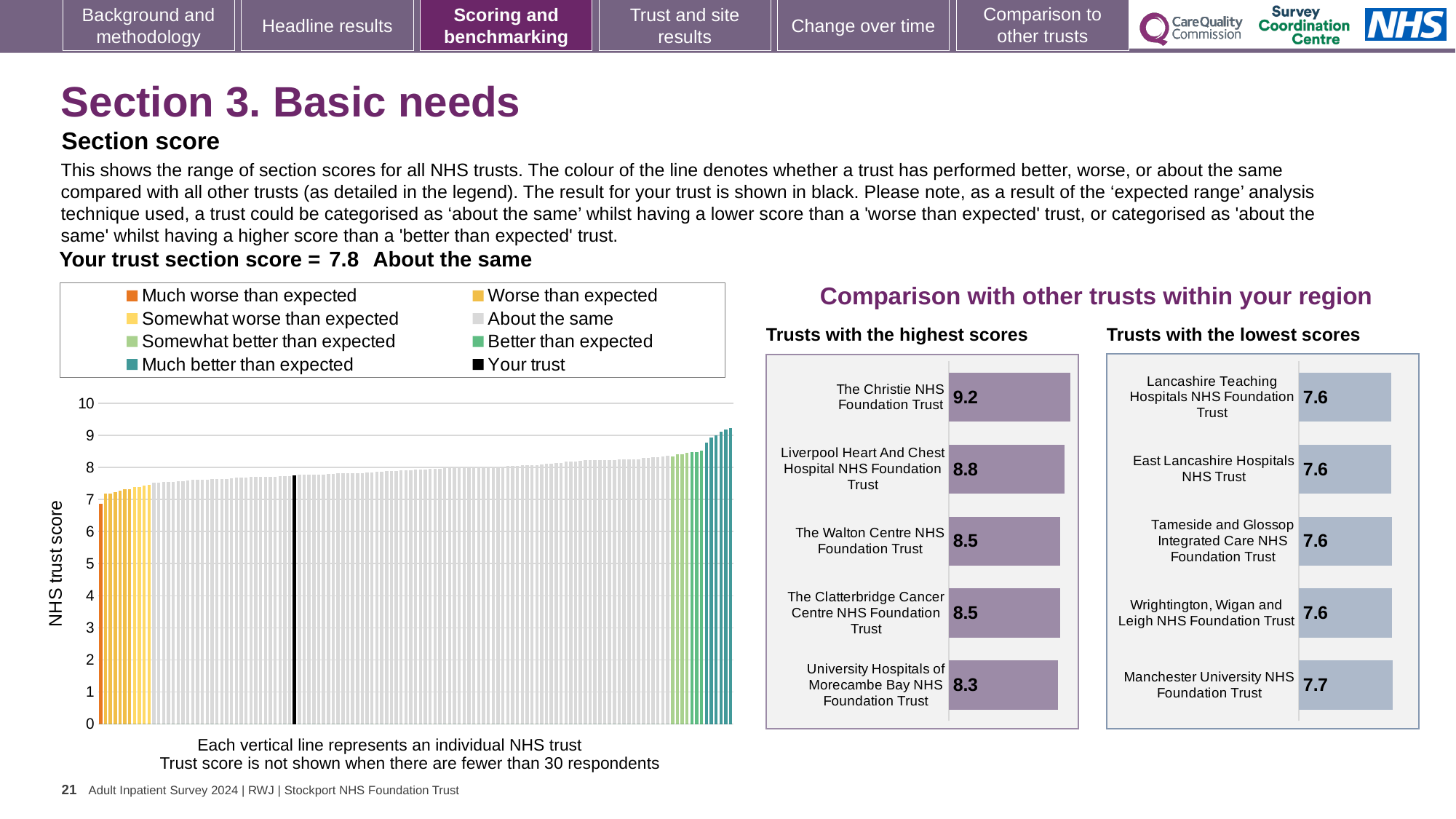
In the 'Trusts with the highest scores' chart, how many trusts are shown? 5 In the 'Trusts with the lowest scores' chart, what is the difference between the scores of Manchester University NHS Foundation Trust and East Lancashire Hospitals NHS Trust? 0.1 In the 'Trusts with the highest scores' chart, what is the score for University Hospitals of Morecambe Bay NHS Foundation Trust? 8.3 In the 'Trusts with the highest scores' chart, what is the difference between the scores of The Christie NHS Foundation Trust and Liverpool Heart And Chest Hospital NHS Foundation Trust? 0.4 In the 'Trusts with the lowest scores' chart, which trust has the highest score? Manchester University NHS Foundation Trust In the 'Trusts with the highest scores' chart, which trust has the highest score? The Christie NHS Foundation Trust In the 'Trusts with the highest scores' chart, which is larger: the score for The Walton Centre NHS Foundation Trust or the score for University Hospitals of Morecambe Bay NHS Foundation Trust? The Walton Centre NHS Foundation Trust In the large chart on the left showing NHS trust scores, what is the section score for your trust (the black bar)? 7.8 In the large chart on the left showing NHS trust scores, do the values rise or fall from left to right? rise In the 'Trusts with the lowest scores' chart, what is the score for Manchester University NHS Foundation Trust? 7.7 In the 'Trusts with the highest scores' chart, what is the score for The Christie NHS Foundation Trust? 9.2 How many entries does the legend of the large chart on the left list? 8